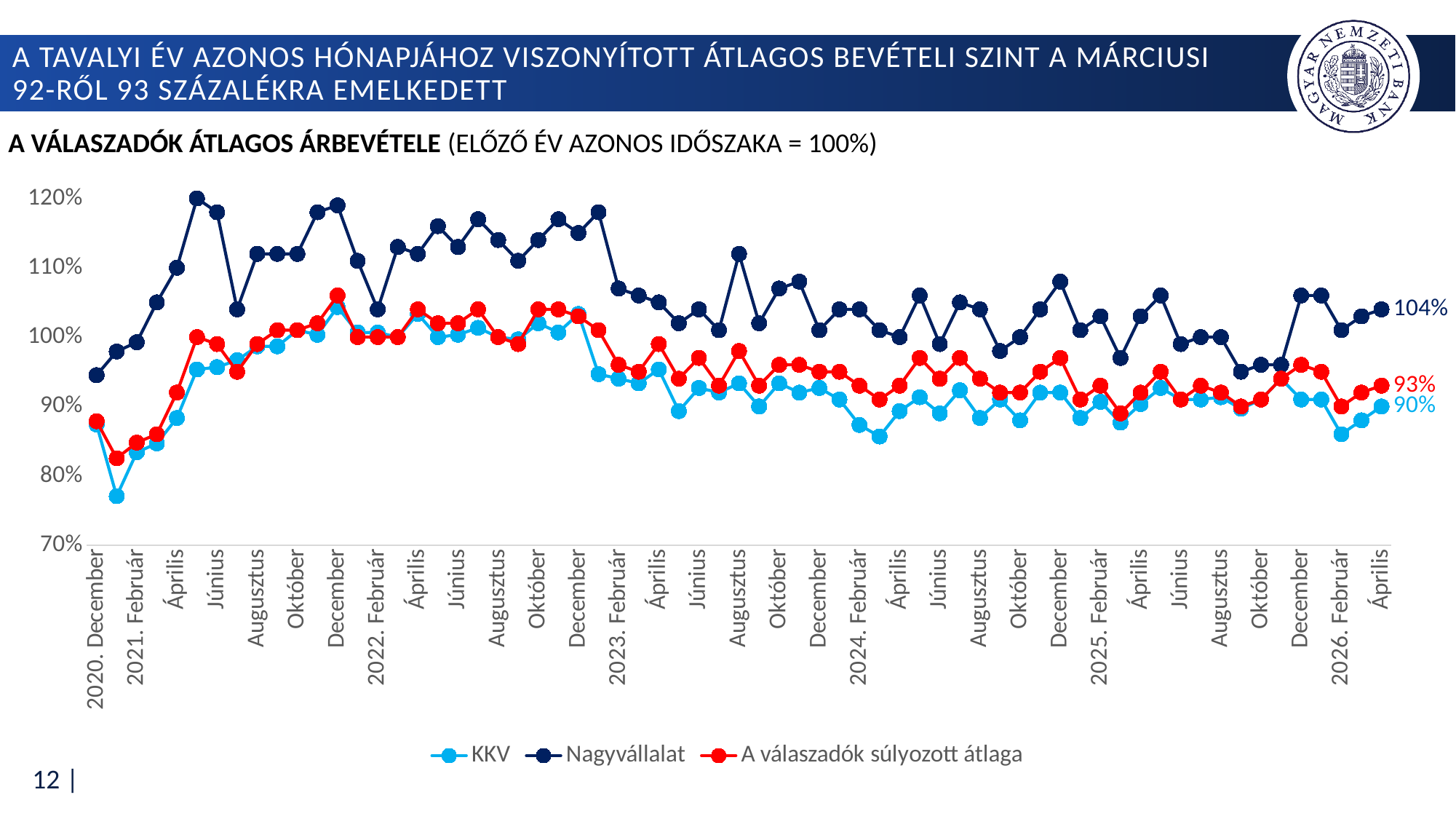
Is the Nagyvállalat value at 2021. Június greater or less than 110%? greater At the last point (2026. Április), which is larger: the Nagyvállalat value or the weighted average ('A válaszadók súlyozott átlaga')? Nagyvállalat Which series has the highest value at the last point (2026. Április)? Nagyvállalat Does the Nagyvállalat series generally rise or fall from 2022. December to 2026. Április? Fall Is the KKV value at 2020. December greater or less than 90%? less What kind of chart is shown on the slide? Line chart What is the value of the Nagyvállalat series at the last point (2026. Április)? 104% What is the value of the KKV series at the last point (2026. Április)? 90% How many series does the legend list? 3 What is the value of 'A válaszadók súlyozott átlaga' at the last point (2026. Április)? 93% Which series has the lowest value at the last point (2026. Április)? KKV What is the difference between the Nagyvállalat and KKV values at the last point (2026. Április)? 14 percentage points